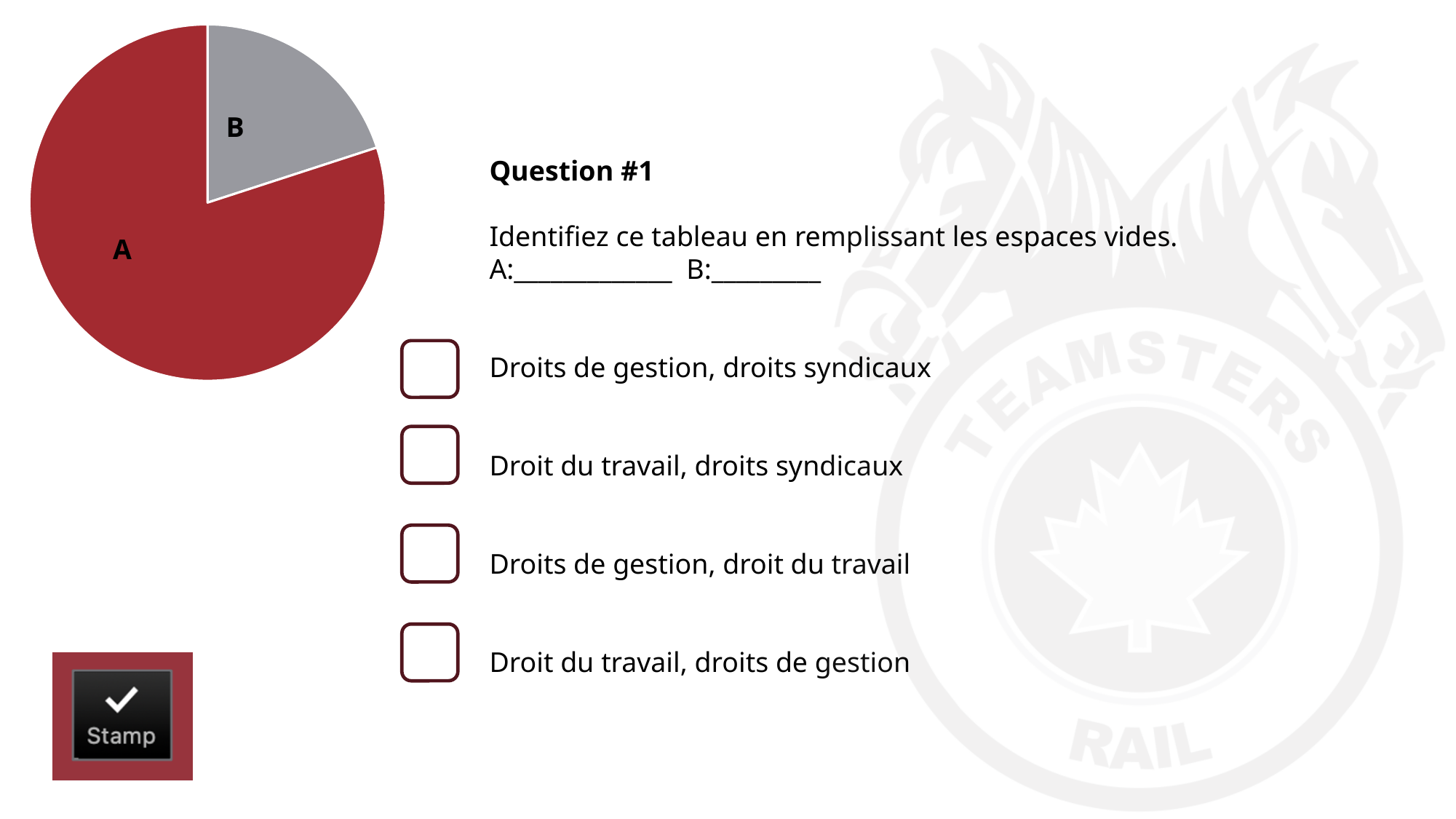
Which slice is larger in the pie chart, A or B? A What colour is slice A in the pie chart? dark red Does slice A take up more or less than half of the pie chart? more How many slices does the pie chart have? 2 What colour is slice B in the pie chart? gray Which slice of the pie chart is the largest? A Which slice of the pie chart is the smallest? B What kind of chart is shown on the slide? pie chart